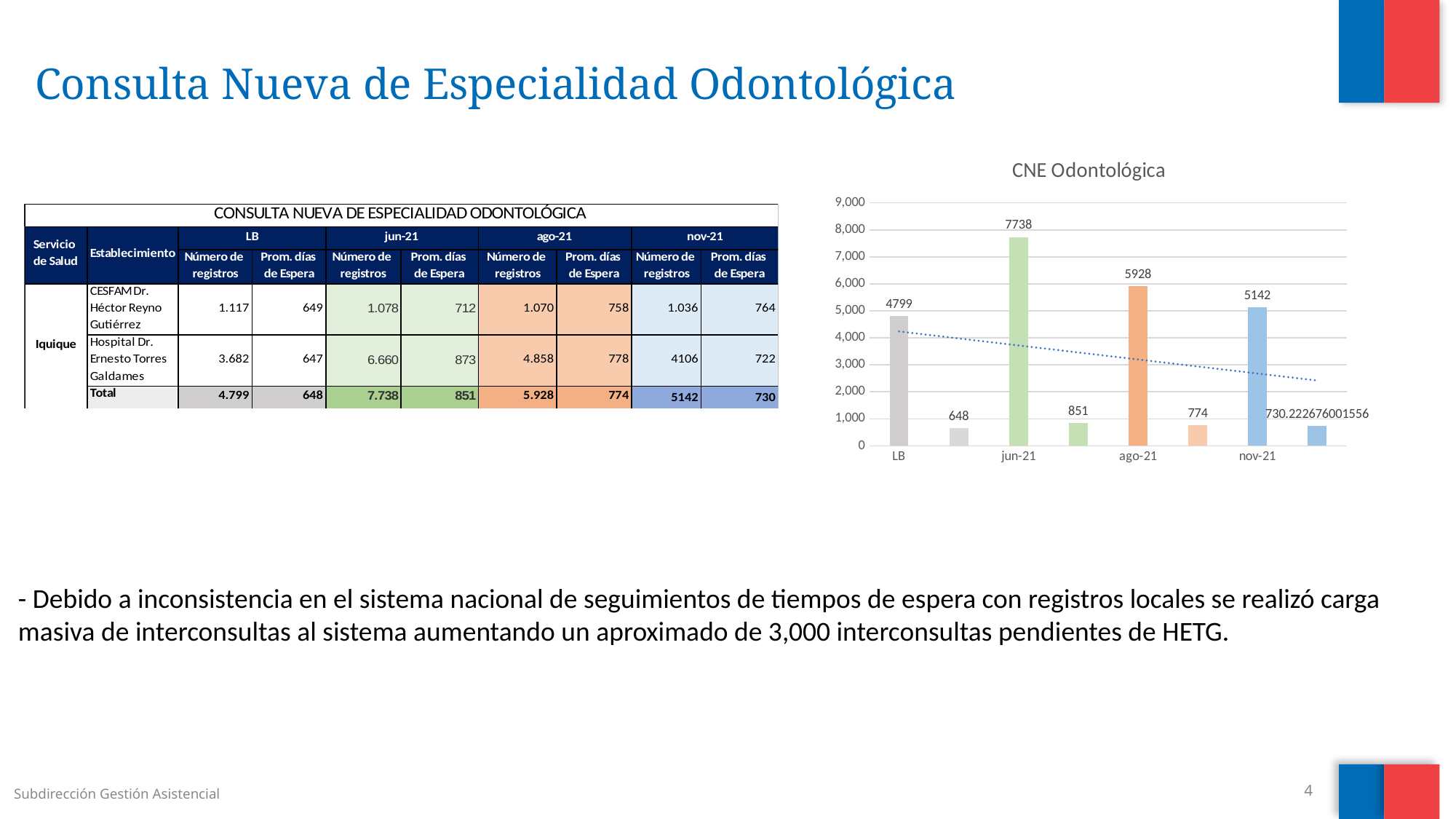
In the CNE Odontológica chart, which category has the lowest tall bar? LB How many categories are shown on the x axis of the CNE Odontológica chart? 4 In the CNE Odontológica chart, which is larger: the tall bar for ago-21 or the tall bar for nov-21? ago-21 In the CNE Odontológica chart, is the tall bar for nov-21 greater or less than 5,000? greater In the CNE Odontológica chart, what is the value of the tall bar for jun-21? 7738 In the CNE Odontológica chart, what is the value of the short bar for ago-21? 774 In the CNE Odontológica chart, which category has the highest tall bar? jun-21 In the CNE Odontológica chart, what is the value of the tall bar for LB? 4799 What is the title of the chart on the slide? CNE Odontológica In the CNE Odontológica chart, what is the value of the short bar for jun-21? 851 What kind of chart is the CNE Odontológica chart? bar chart In the CNE Odontológica chart, what is the difference between the tall bars for jun-21 and ago-21? 1810